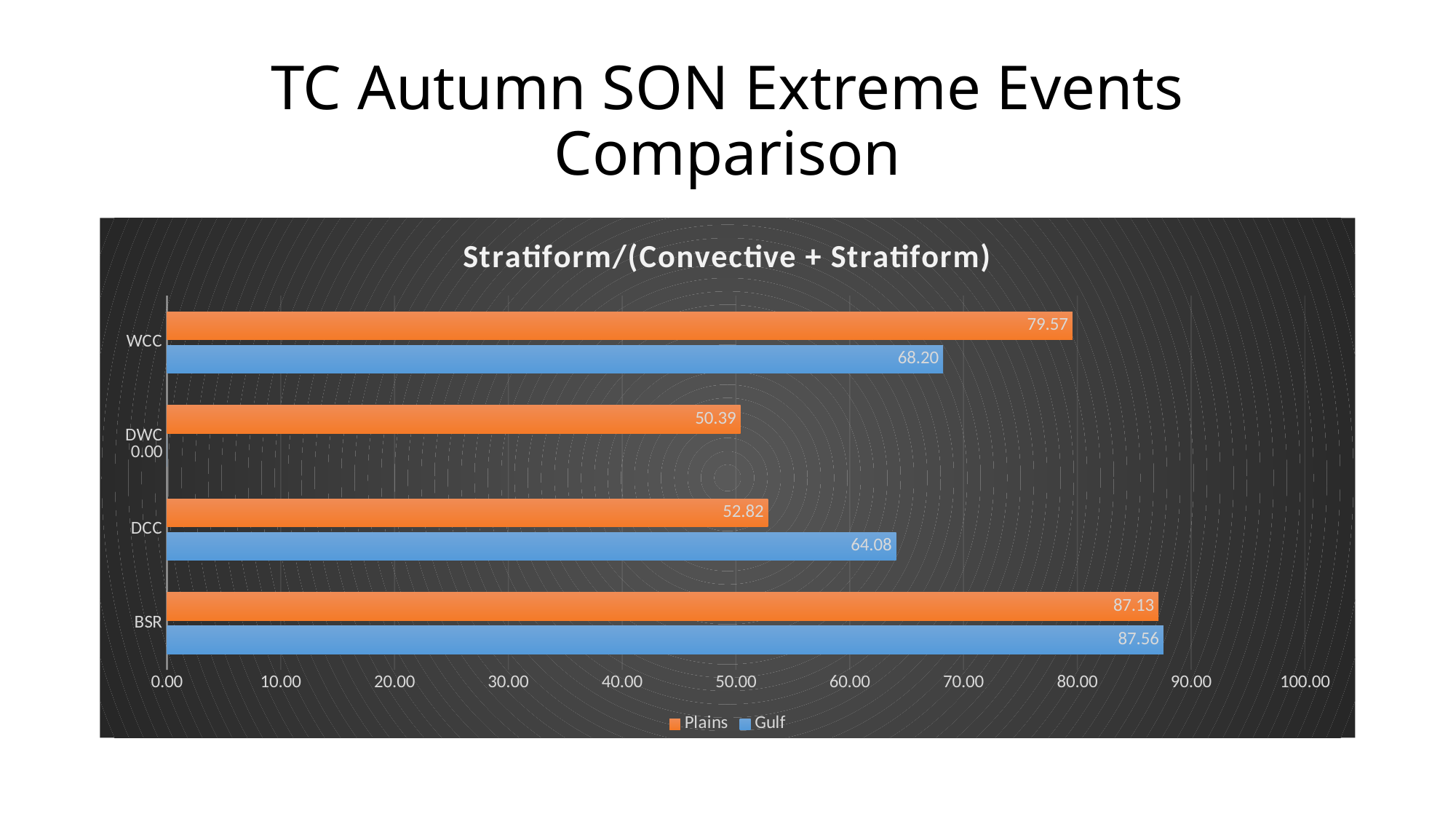
How many categories are shown on the chart? 4 Which category has the highest Plains value? BSR What is the Plains value for WCC? 79.57 Which category has the lowest Plains value? DWC How many series does the legend list? 2 For DCC, which series has the larger value, Plains or Gulf? Gulf What is the Plains value for BSR? 87.13 What is the Gulf value for DWC? 0.00 Which category has the lowest Gulf value? DWC What is the Gulf value for DCC? 64.08 What type of chart is shown on the slide? Bar chart What is the difference between the Plains and Gulf values for WCC? 11.37